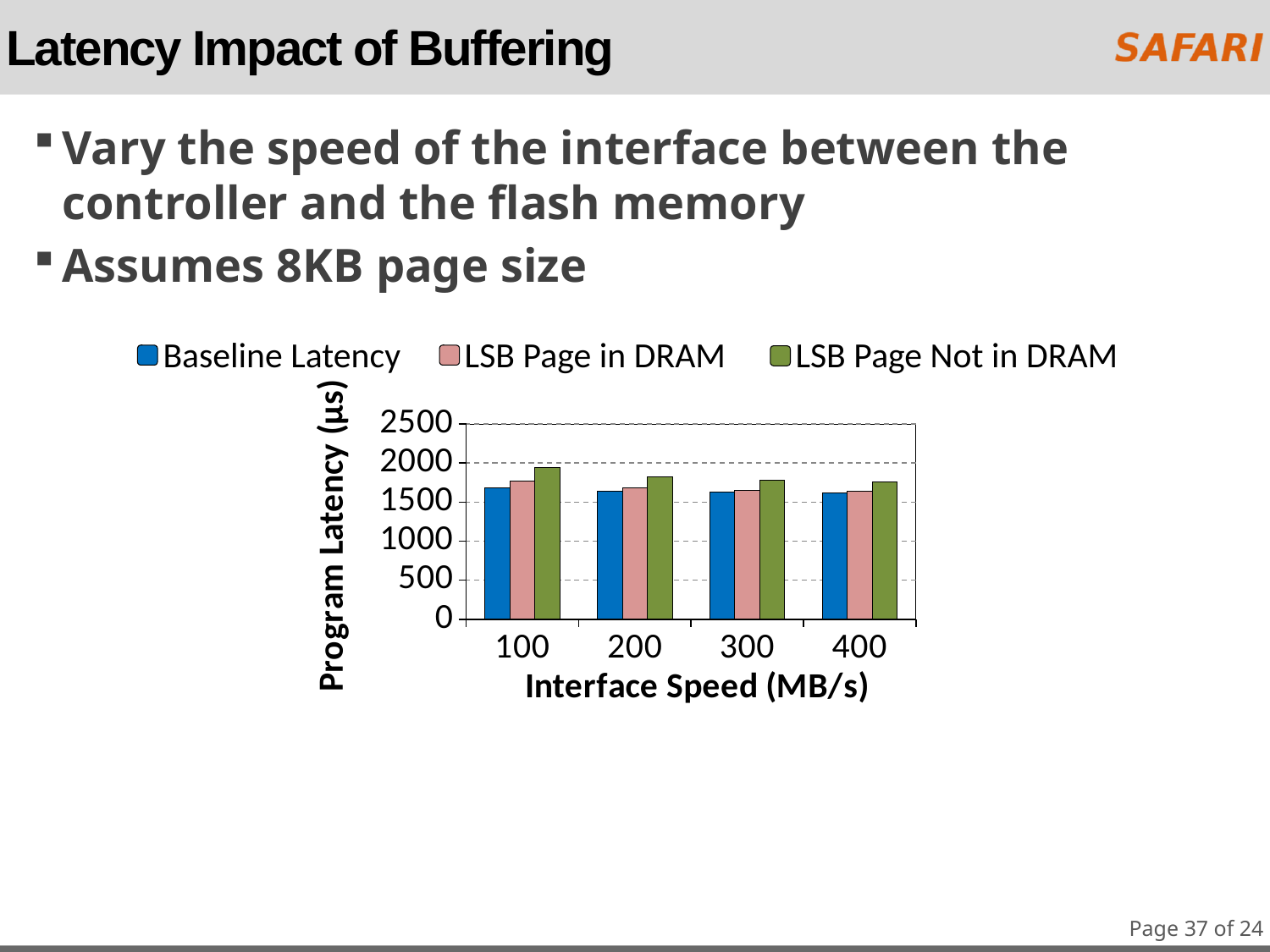
How many series does the legend list? 3 Is the value for Baseline Latency at 400 MB/s greater or less than 2000? less What is the label of the y axis? Program Latency (μs) Does the LSB Page Not in DRAM latency rise or fall as interface speed increases from 100 to 400 MB/s? fall Is the value for LSB Page Not in DRAM at 100 MB/s greater or less than 1500? greater What is the label of the x axis? Interface Speed (MB/s) Which series has the lowest program latency at an interface speed of 100 MB/s? Baseline Latency What kind of chart is shown on the slide? bar chart At 100 MB/s, which is larger: Baseline Latency or LSB Page Not in DRAM? LSB Page Not in DRAM Which series has the highest program latency at an interface speed of 100 MB/s? LSB Page Not in DRAM How many interface speed categories are shown on the x axis? 4 At 400 MB/s, which is larger: LSB Page in DRAM or LSB Page Not in DRAM? LSB Page Not in DRAM